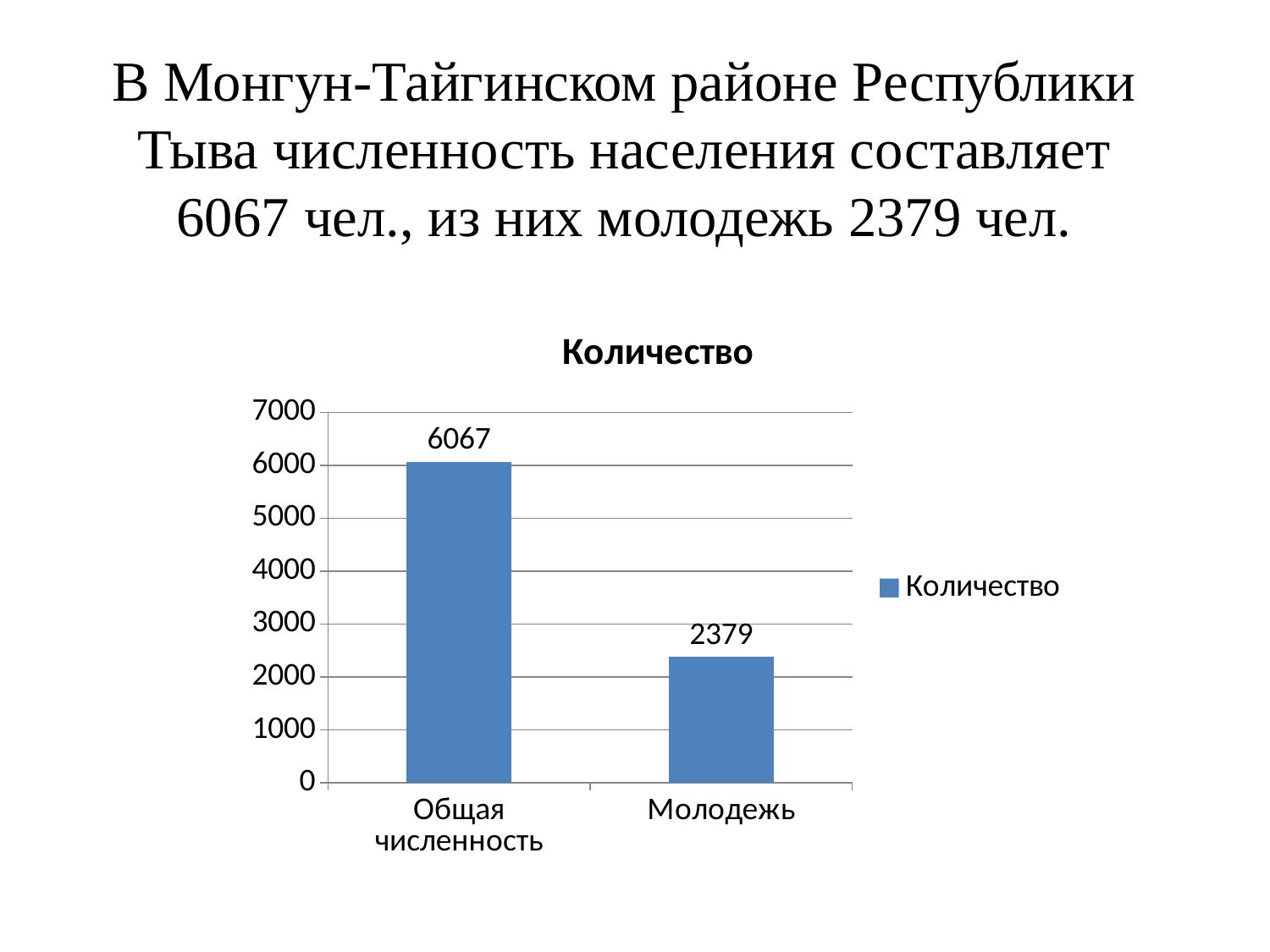
Which category has the highest value? Общая численность What is the title of the chart? Количество What is the value for Общая численность? 6067 How many categories are shown on the x axis? 2 Which is larger, the value for Общая численность or the value for Молодежь? Общая численность Which category has the lowest value? Молодежь What is the difference between the values for Общая численность and Молодежь? 3688 What kind of chart is shown? bar chart What is the value for Молодежь? 2379 How many series does the legend list? 1 Is the value for Общая численность greater or less than 5000? greater Is the value for Молодежь greater or less than 3000? less